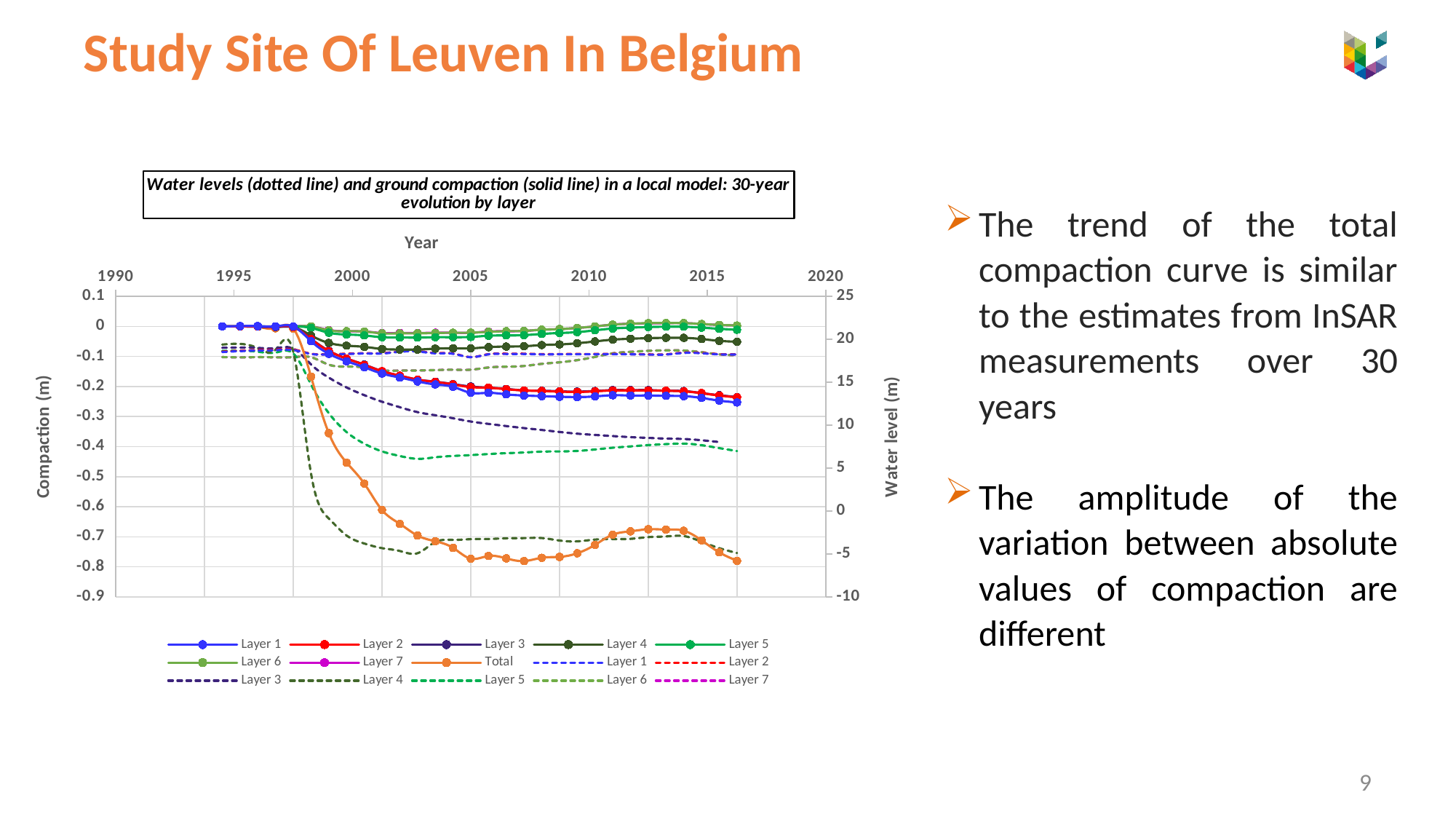
What is the title of the chart? Water levels (dotted line) and ground compaction (solid line) in a local model: 30-year evolution by layer Is the Layer 1 solid-line compaction value in 2015 greater or less than -0.2? less Does the Total compaction curve rise or fall between 1997 and 2007? fall Which solid series has the lower compaction value in 2010, Total or Layer 1? Total Is the Layer 4 solid-line compaction value in 2010 greater or less than -0.1? greater Which solid series reaches the lowest compaction value on the chart? Total How many series does the chart legend list? 15 Does the Layer 1 solid compaction line rise or fall between 1998 and 2016? fall What is the label of the left vertical axis? Compaction (m) What kind of chart is shown on the slide? line chart